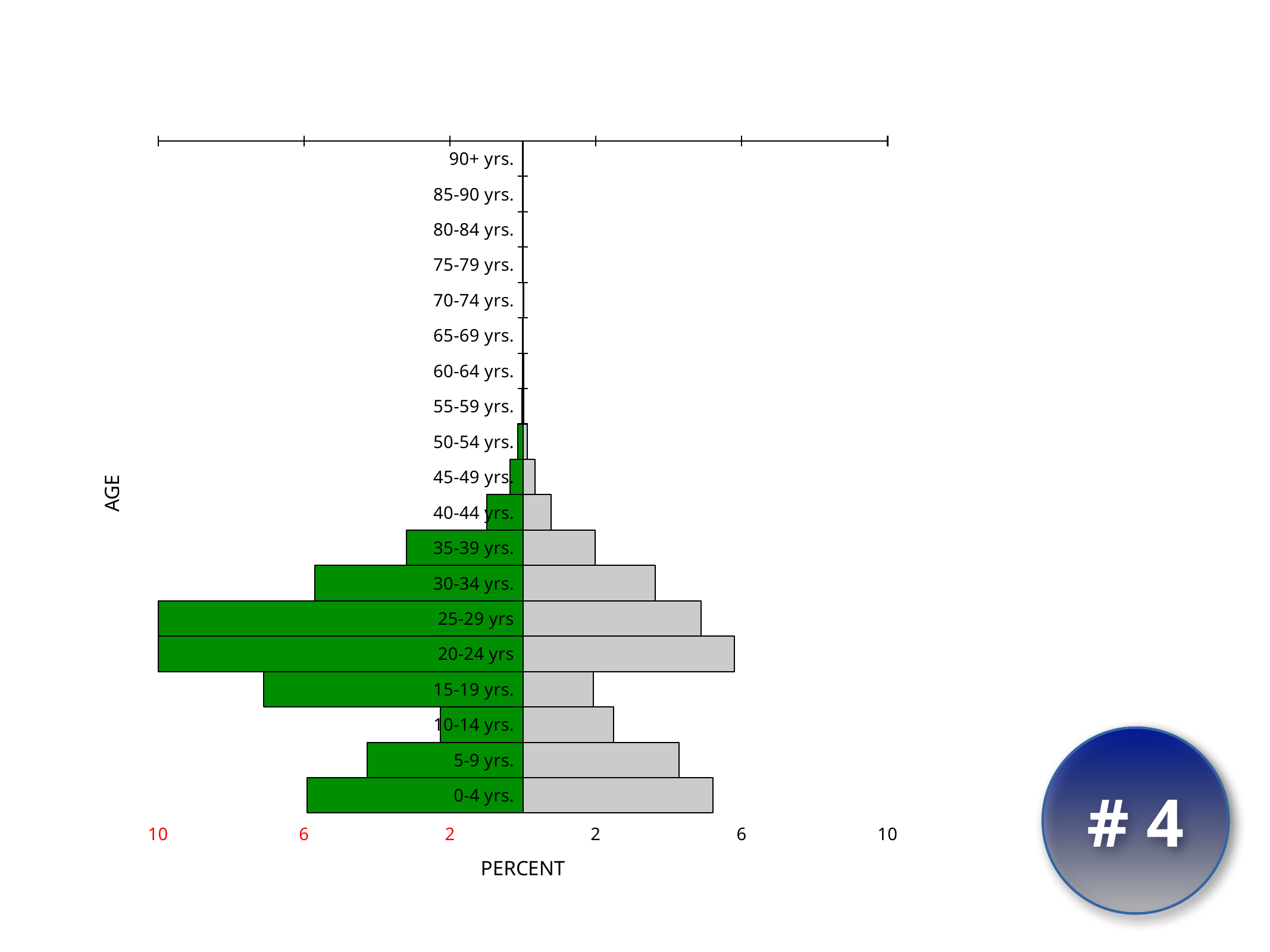
Is the value of the green bar for 15-19 yrs. greater or less than 6? greater Is the value of the green bar for 30-34 yrs. greater or less than 6? less Is the value of the grey bar for 30-34 yrs. greater or less than 2? greater What kind of chart is shown on the slide? bar chart For 30-34 yrs., which bar is longer, the green bar or the grey bar? the green bar Which age group has the longest grey bar? 20-24 yrs How many age categories are listed on the vertical axis? 19 What is the title of the vertical axis? AGE Which green bar is longer, 15-19 yrs. or 0-4 yrs.? 15-19 yrs. What is the title of the horizontal axis? PERCENT